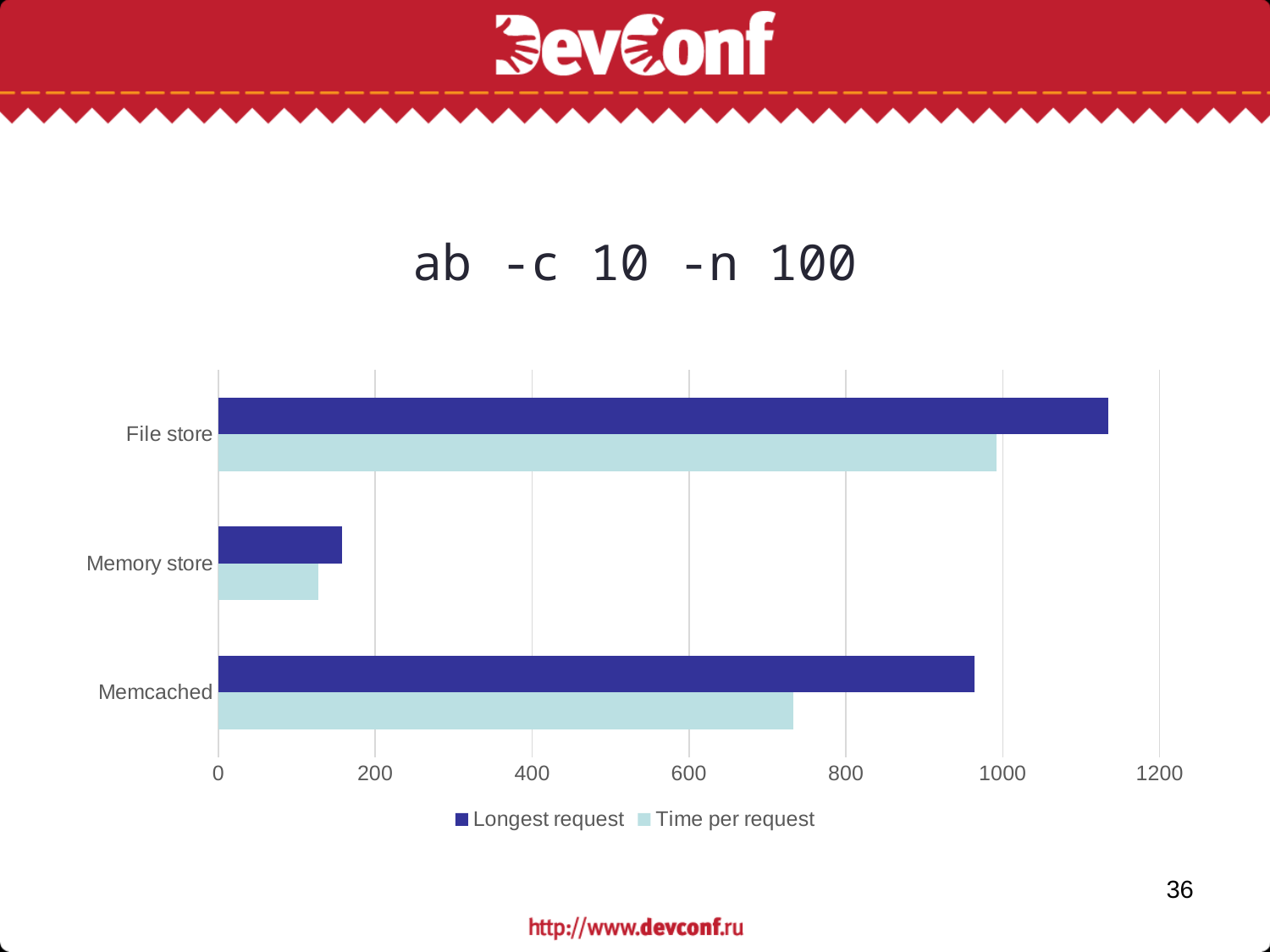
Is the Longest request value for Memcached greater or less than 800? greater How many series does the legend list? 2 For File store, which is larger: Longest request or Time per request? Longest request Which is larger for Longest request: File store or Memcached? File store What kind of chart is shown on the slide? bar chart Which category has the highest value for Longest request? File store Is the Longest request value for Memory store greater or less than 200? less Is the Time per request value for Memcached greater or less than 800? less What is the title shown above the chart? ab -c 10 -n 100 How many categories are shown on the chart? 3 Which category has the lowest value for Time per request? Memory store